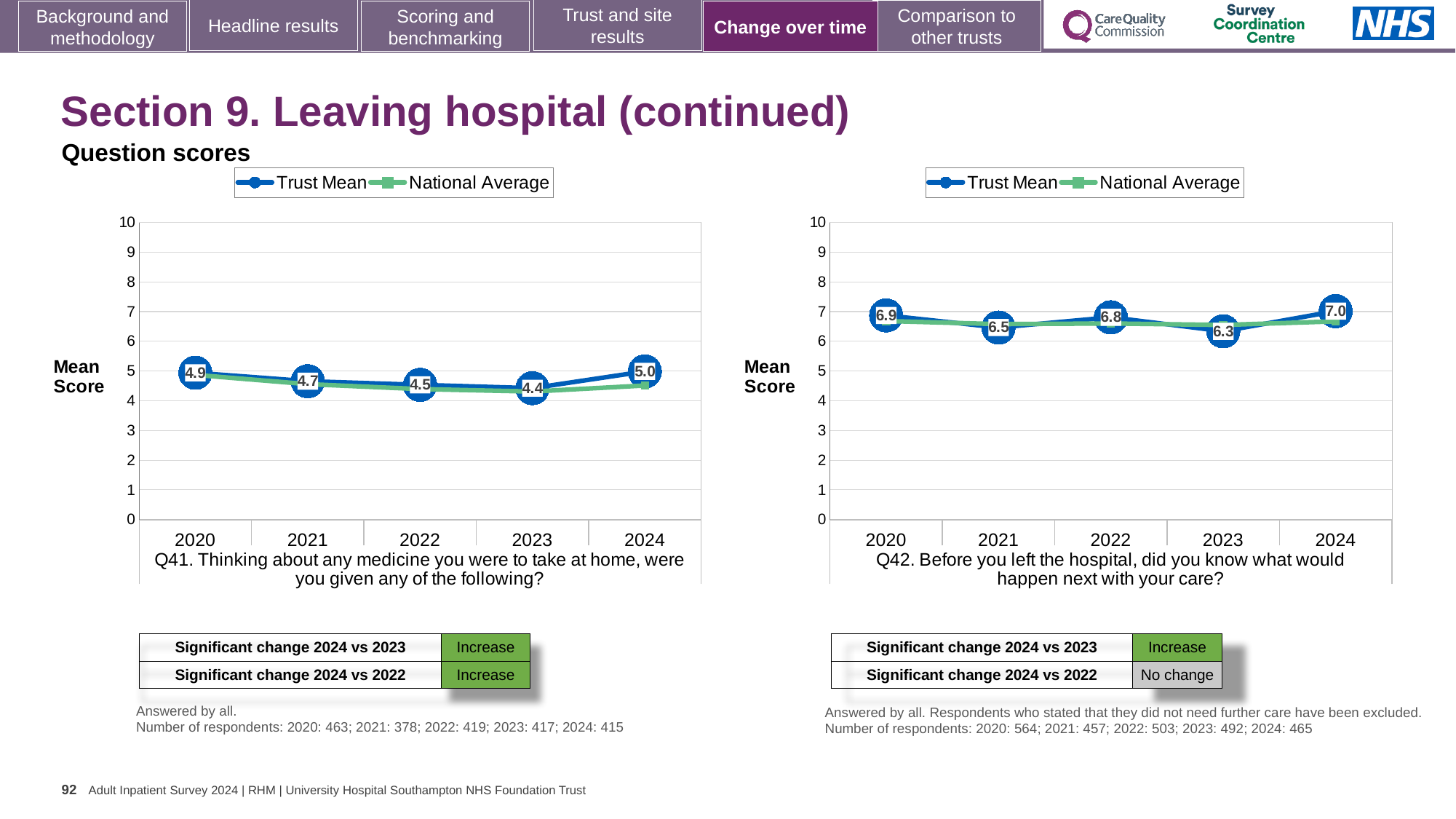
In the Q41 chart (left), what is the Trust Mean score for 2021? 4.7 How many series does the legend of the Q41 chart (left) list? 2 What kind of chart is the Q42 chart (right)? Line chart In the Q42 chart (right), is the Trust Mean score for 2020 or 2021 larger? 2020 In the Q42 chart (right), what is the Trust Mean score for 2023? 6.3 In the Q42 chart (right), is the National Average for 2024 greater or less than 6? greater In the Q41 chart (left), what is the Trust Mean score for 2024? 5.0 In the Q42 chart (right), what is the difference between the Trust Mean scores for 2022 and 2021? 0.3 In the Q41 chart (left), how many years are plotted on the x axis? 5 In the Q42 chart (right), which year has the highest Trust Mean score? 2024 In the Q41 chart (left), what is the difference between the Trust Mean scores for 2024 and 2023? 0.6 In the Q41 chart (left), which year has the lowest Trust Mean score? 2023